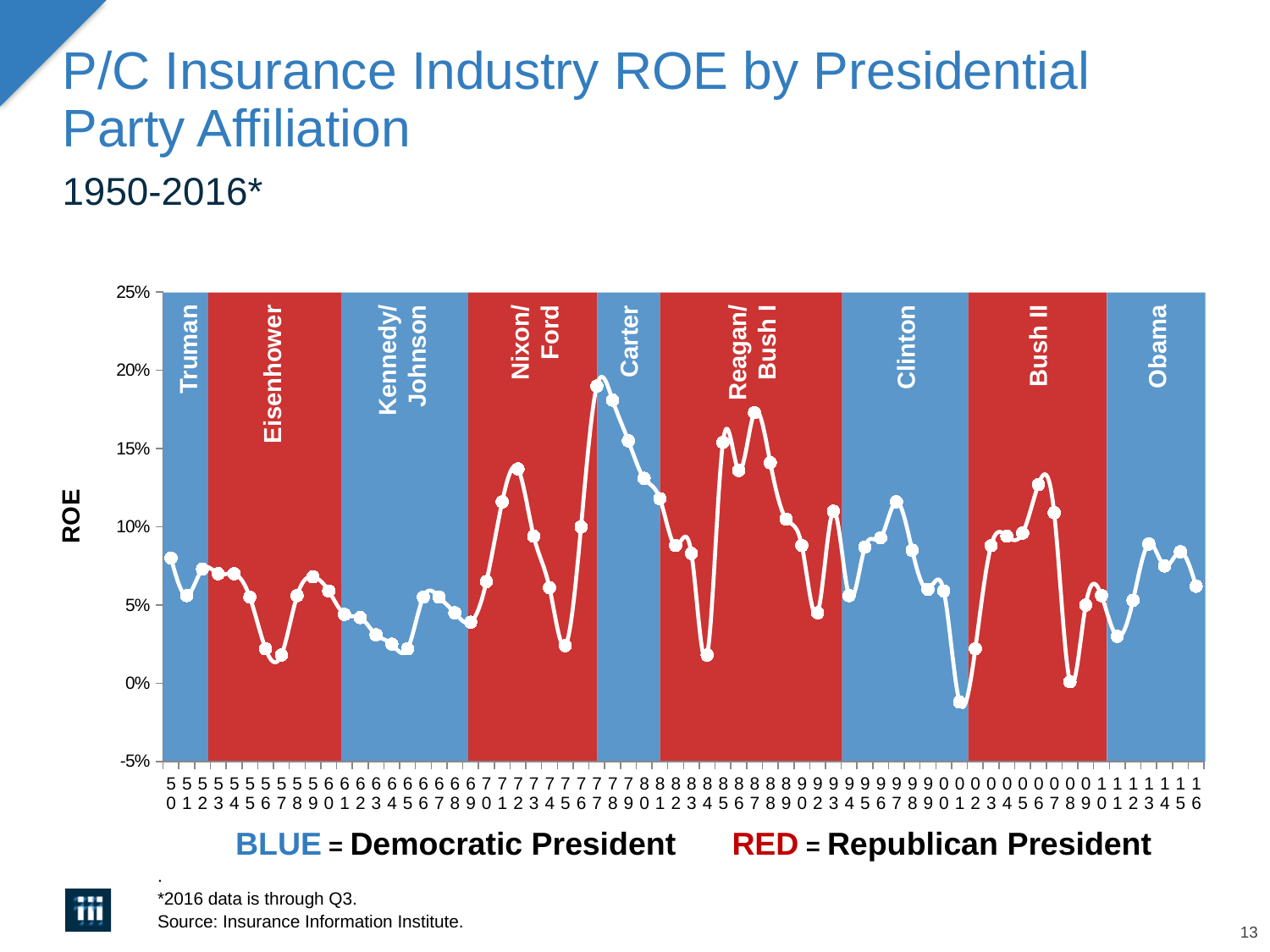
What kind of chart is shown on the slide? line chart Is the ROE value for 1977 greater or less than 15%? greater Is the ROE value for 2001 greater or less than 0%? less Is the ROE value for 1984 greater or less than 5%? less In which year does the ROE line reach its highest point? 1977 Does the ROE line rise or fall from 1975 to 1977? rise How many presidential administration bands are labelled across the chart? 9 Which year has the higher ROE, 1987 or 1984? 1987 What is the title of the chart? P/C Insurance Industry ROE by Presidential Party Affiliation In which year does the ROE line reach its lowest point? 2001 According to the legend below the chart, what does a blue band represent? Democratic President